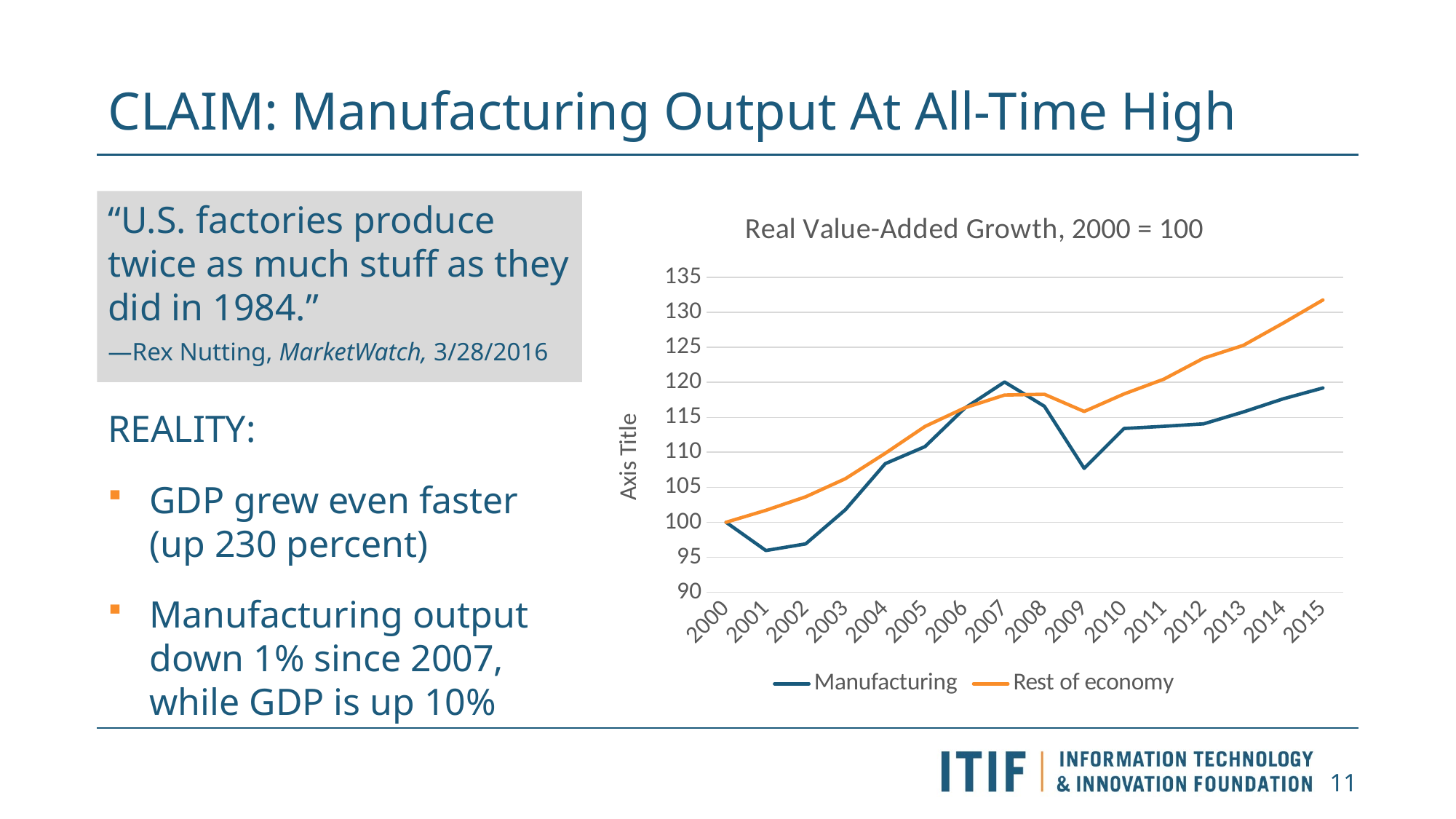
In 2009, which series has the higher value, Manufacturing or Rest of economy? Rest of economy Is the value for Rest of economy in 2015 greater or less than 130? greater Is the value for Manufacturing in 2001 greater or less than 100? less What kind of chart is shown on the slide? line chart Does the Manufacturing series rise or fall from 2007 to 2009? fall How many years are plotted along the x axis of the chart? 16 In 2015, which series has the higher value, Manufacturing or Rest of economy? Rest of economy Is the value for Manufacturing in 2009 greater or less than 110? less What is the title of the chart? Real Value-Added Growth, 2000 = 100 How many series does the chart's legend list? 2 What is the value for Manufacturing in 2000? 100 In which year is the Rest of economy series at its highest? 2015